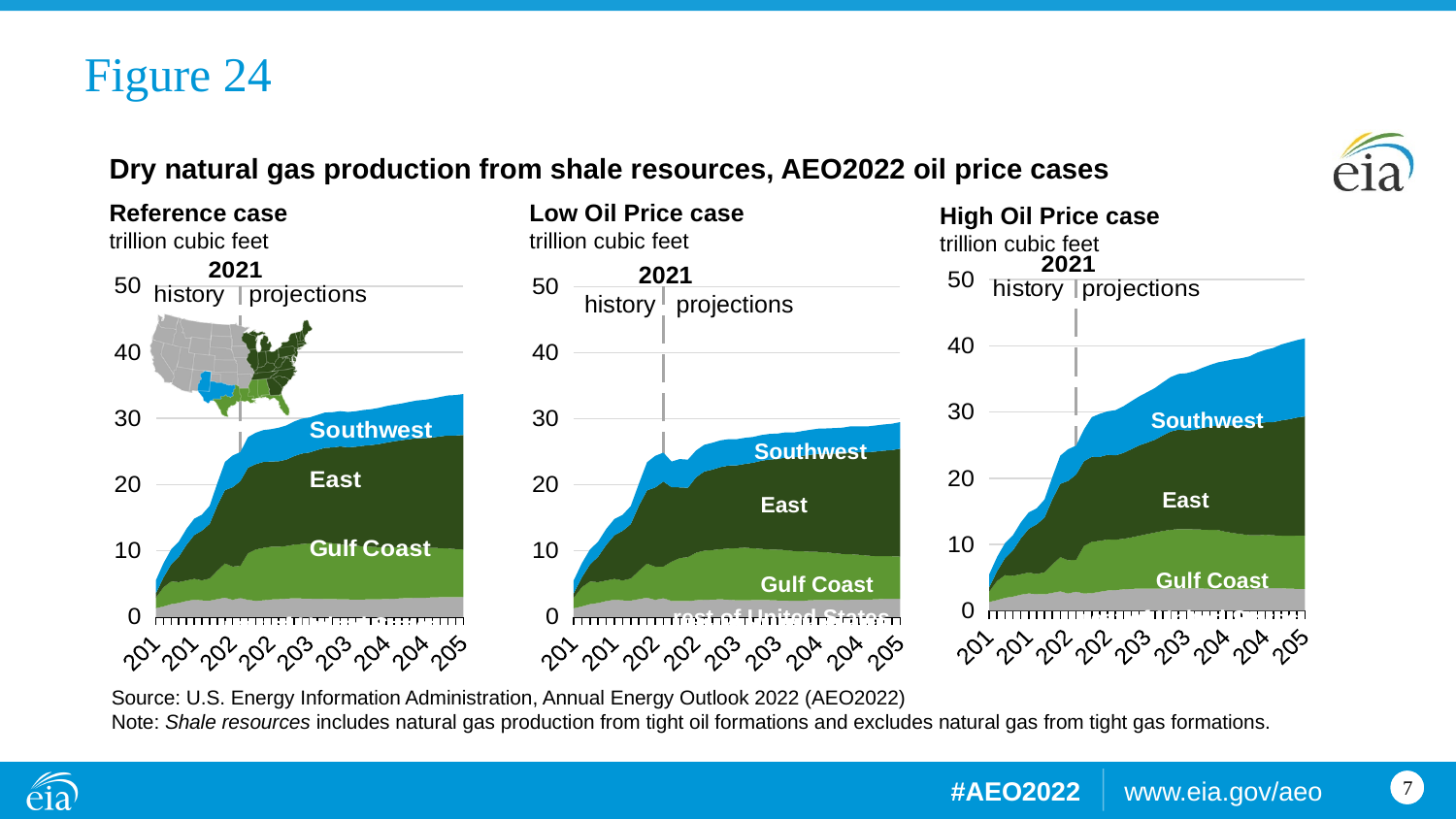
What unit is used on the y axis of the three charts? trillion cubic feet In the Reference case chart, is the total shale gas production at the end of the projection period greater or less than 40? less Which of the three cases shows the highest total shale gas production at the end of the projection period? High Oil Price case In the Low Oil Price case chart, is the total shale gas production at the end of the projection period greater or less than 20? greater In the High Oil Price case chart, is the total shale gas production at the end of the projection period greater or less than 30? greater In the Reference case chart, which labeled region contributes the largest share of shale gas production at the end of the projection period? East What kind of chart is the Reference case chart? stacked area chart Which of the three cases shows the lowest total shale gas production at the end of the projection period? Low Oil Price case In the High Oil Price case chart, does total shale gas production rise or fall over the projection period? rise What is the overall title of the charts on the slide? Dry natural gas production from shale resources, AEO2022 oil price cases